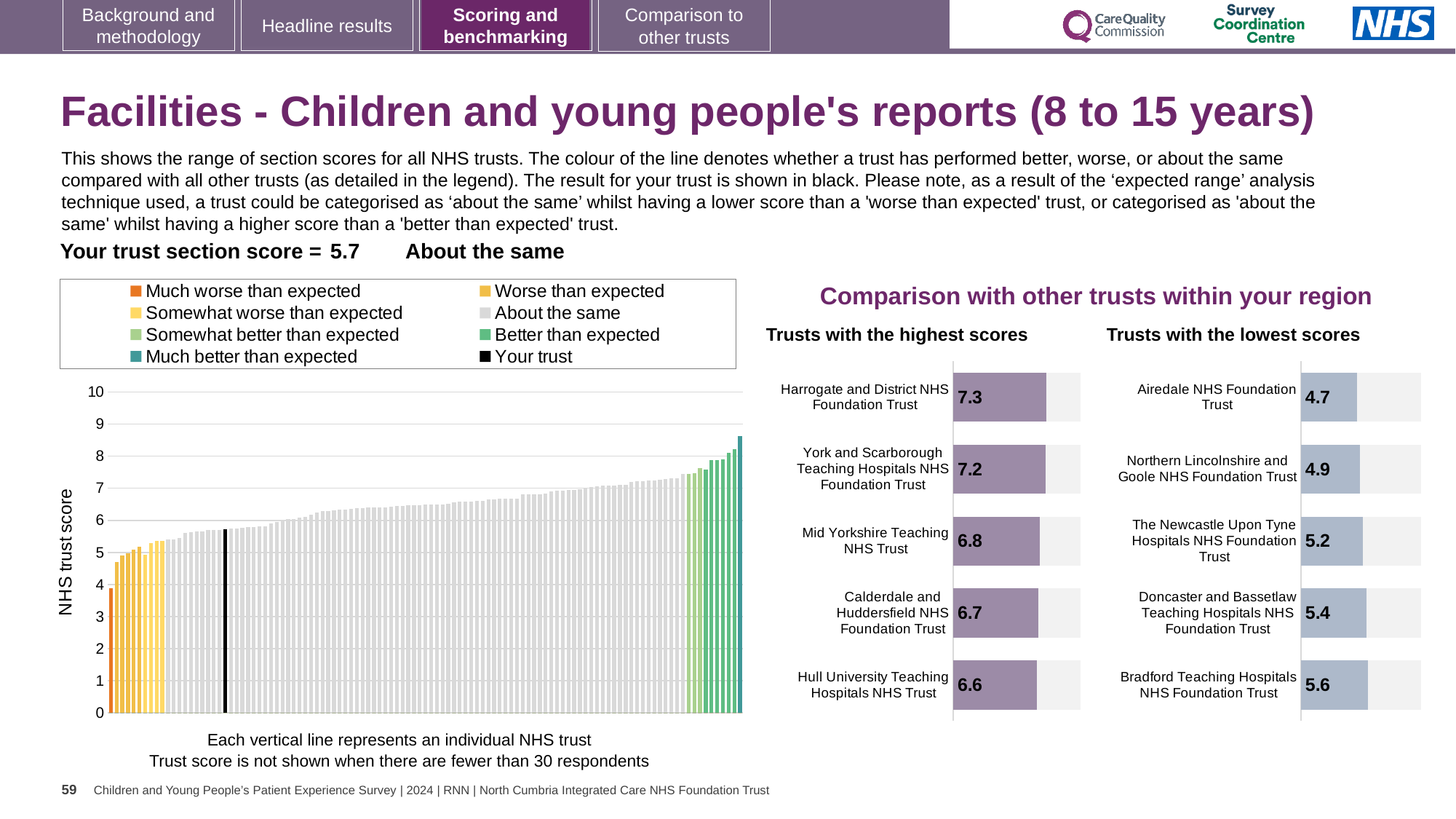
In the 'Trusts with the highest scores' chart, what is the score for Harrogate and District NHS Foundation Trust? 7.3 What kind of chart is the main chart on the left showing NHS trust scores? Bar chart In the main NHS trust score chart, do the bar values rise or fall from left to right? Rise In the 'Trusts with the highest scores' chart, what is the difference between the scores of Harrogate and District NHS Foundation Trust and Hull University Teaching Hospitals NHS Trust? 0.7 In the 'Trusts with the highest scores' chart, which trust has the highest score? Harrogate and District NHS Foundation Trust How many trusts are shown in the 'Trusts with the highest scores' chart? 5 In the 'Trusts with the lowest scores' chart, what is the score for Doncaster and Bassetlaw Teaching Hospitals NHS Foundation Trust? 5.4 In the 'Trusts with the lowest scores' chart, which trust has the lowest score? Airedale NHS Foundation Trust How many entries does the legend of the main NHS trust score chart list? 8 In the 'Trusts with the lowest scores' chart, what is the score for Airedale NHS Foundation Trust? 4.7 In the 'Trusts with the highest scores' chart, which has the larger score: Mid Yorkshire Teaching NHS Trust or Calderdale and Huddersfield NHS Foundation Trust? Mid Yorkshire Teaching NHS Trust In the 'Trusts with the lowest scores' chart, how much higher is Bradford Teaching Hospitals NHS Foundation Trust's score than Airedale NHS Foundation Trust's? 0.9